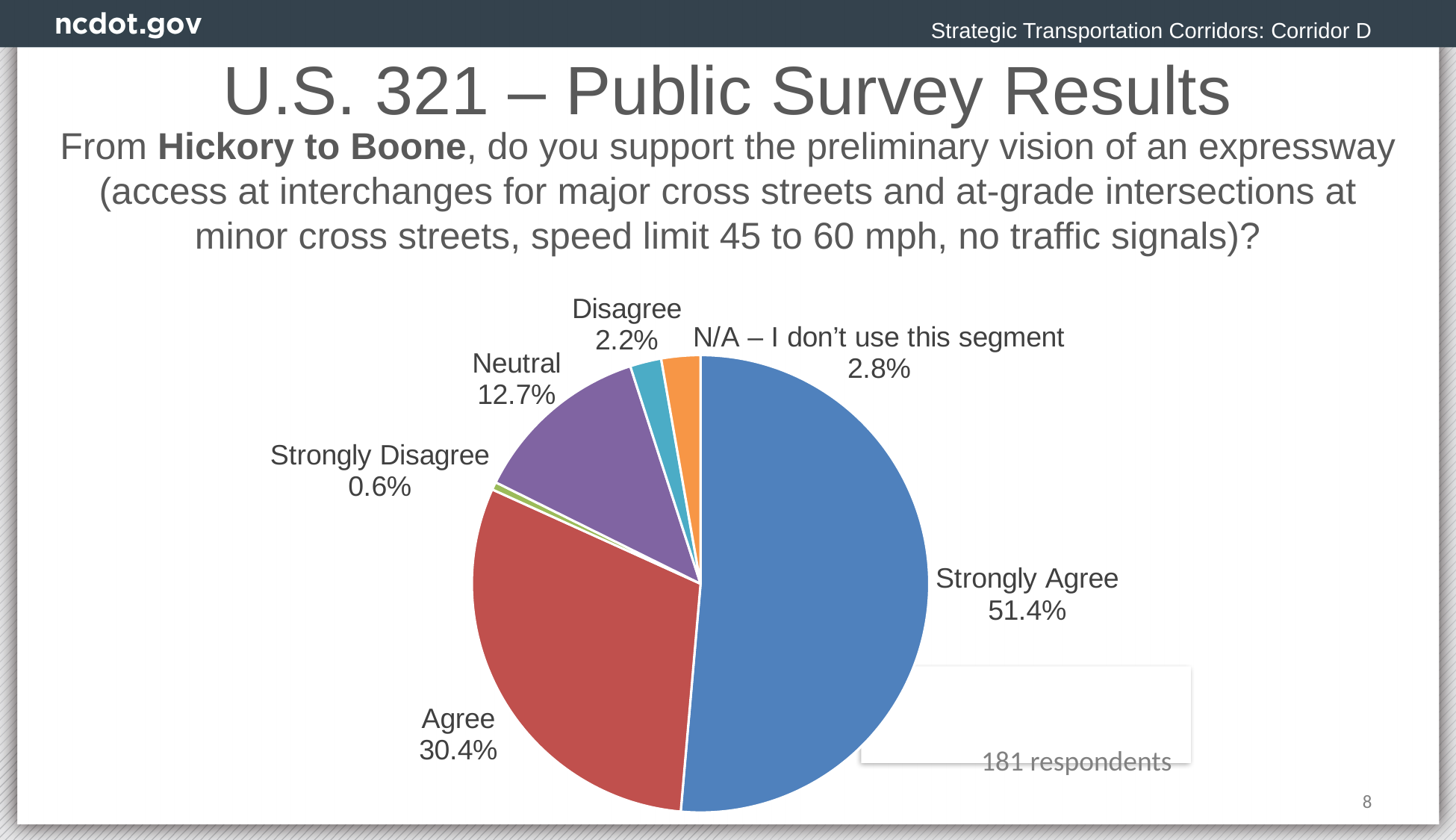
What is the difference in percentage points between Strongly Agree and Agree? 21.0 percentage points How many response categories are shown in the pie chart? 6 Which response category has the smallest slice of the pie? Strongly Disagree What share of respondents chose 'N/A – I don't use this segment'? 2.8% What share of respondents answered Strongly Disagree? 0.6% What share of respondents answered Neutral? 12.7% What kind of chart is shown on the slide? pie chart How many respondents does the chart note say took part in the survey? 181 respondents What share of respondents answered Agree? 30.4% What share of respondents answered Strongly Agree? 51.4% Which is larger, the Disagree slice or the N/A slice? N/A – I don't use this segment Which response category has the largest slice of the pie? Strongly Agree